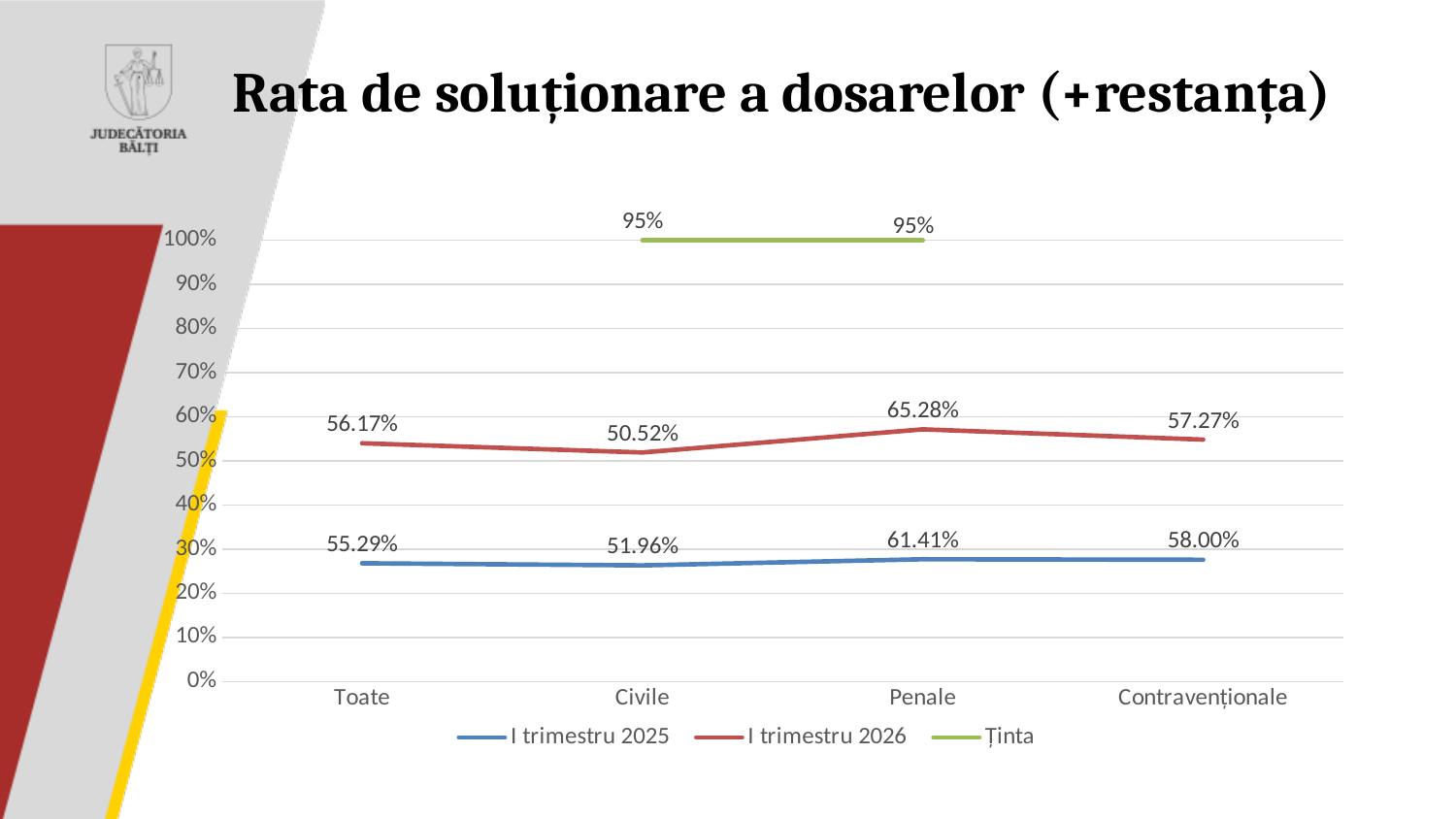
What is the value for Penale in the I trimestru 2026 series? 65.28% How many categories are shown on the x axis? 4 What kind of chart is shown on the slide? line chart Which category has the lowest value in the I trimestru 2026 series? Civile What is the value for Contravenționale in the I trimestru 2026 series? 57.27% What is the difference between the I trimestru 2026 and I trimestru 2025 values for Penale? 3.87% How many series does the legend list? 3 Which category has the highest value in the I trimestru 2025 series? Penale For Contravenționale, which series has the larger value: I trimestru 2025 or I trimestru 2026? I trimestru 2025 What is the title of the chart? Rata de soluționare a dosarelor (+restanța) What is the Ținta value shown for Civile? 95% What is the value for Civile in the I trimestru 2025 series? 51.96%